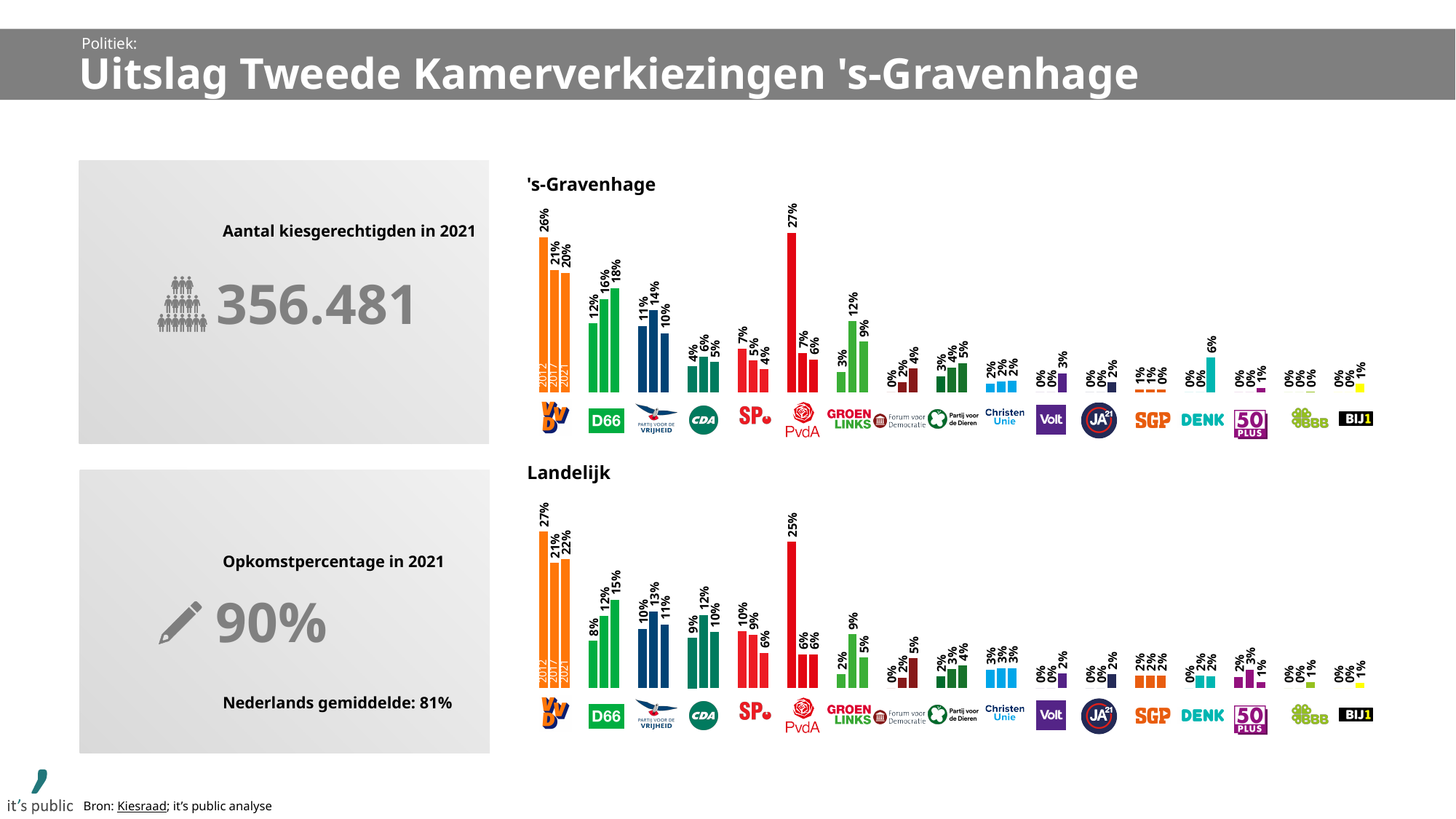
In the 's-Gravenhage chart, what percentage did PvdA get in 2012? 27% In the 's-Gravenhage chart, what is the difference between PvdA's 2012 and 2017 values? 20% In the Landelijk chart, what percentage did CDA get in 2017? 12% In the 's-Gravenhage chart, what percentage did D66 get in 2021? 18% What kind of chart is the 's-Gravenhage chart? bar chart In the 's-Gravenhage chart, do D66's values rise or fall from 2012 to 2021? rise How many years (series) are shown for each party in the Landelijk chart? 3 In the 's-Gravenhage chart, which is larger in 2021: DENK or Volt? DENK In the Landelijk chart, which party has the highest value in 2012? VVD In the 's-Gravenhage chart, which party has the highest value in 2021? VVD In the Landelijk chart, what percentage did VVD get in 2021? 22% In the Landelijk chart, what is the difference between D66's 2021 and 2012 values? 7%